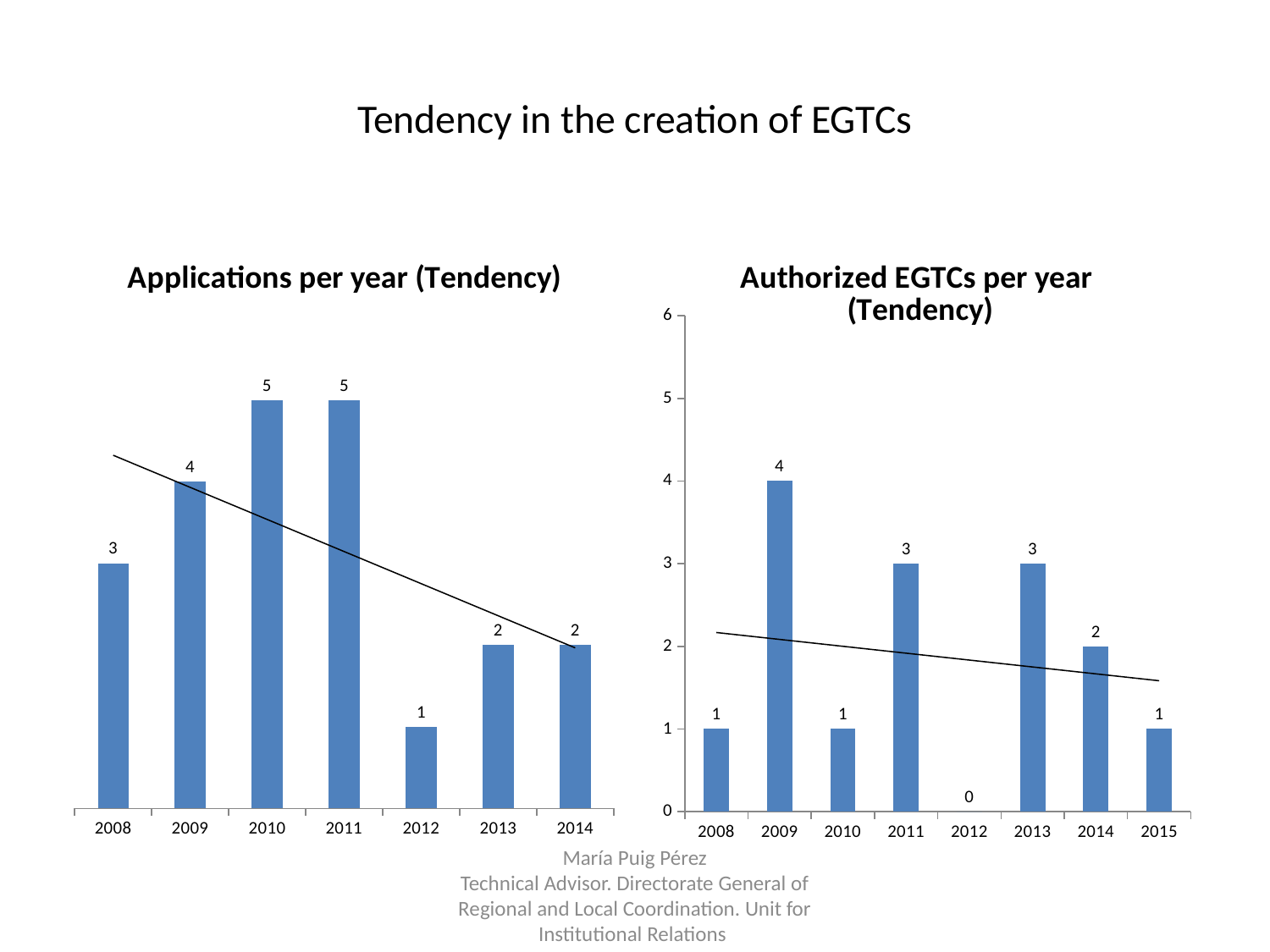
In the 'Authorized EGTCs per year (Tendency)' chart, what is the difference between the values for 2013 and 2014? 1 In the 'Authorized EGTCs per year (Tendency)' chart, what is the value for 2009? 4 In the 'Authorized EGTCs per year (Tendency)' chart, which year has the highest value? 2009 In the 'Applications per year (Tendency)' chart, what is the difference between the values for 2011 and 2012? 4 What kind of chart is the 'Authorized EGTCs per year (Tendency)' chart? Bar chart In the 'Authorized EGTCs per year (Tendency)' chart, what is the value for 2012? 0 In the 'Applications per year (Tendency)' chart, what is the value for 2010? 5 In the 'Applications per year (Tendency)' chart, does the trend line rise or fall from 2008 to 2014? Fall In the 'Applications per year (Tendency)' chart, how many years are shown on the x axis? 7 In the 'Authorized EGTCs per year (Tendency)' chart, how many years are shown on the x axis? 8 In the 'Applications per year (Tendency)' chart, which year has the lowest value? 2012 In the 'Applications per year (Tendency)' chart, which is larger, the value for 2009 or the value for 2013? 2009